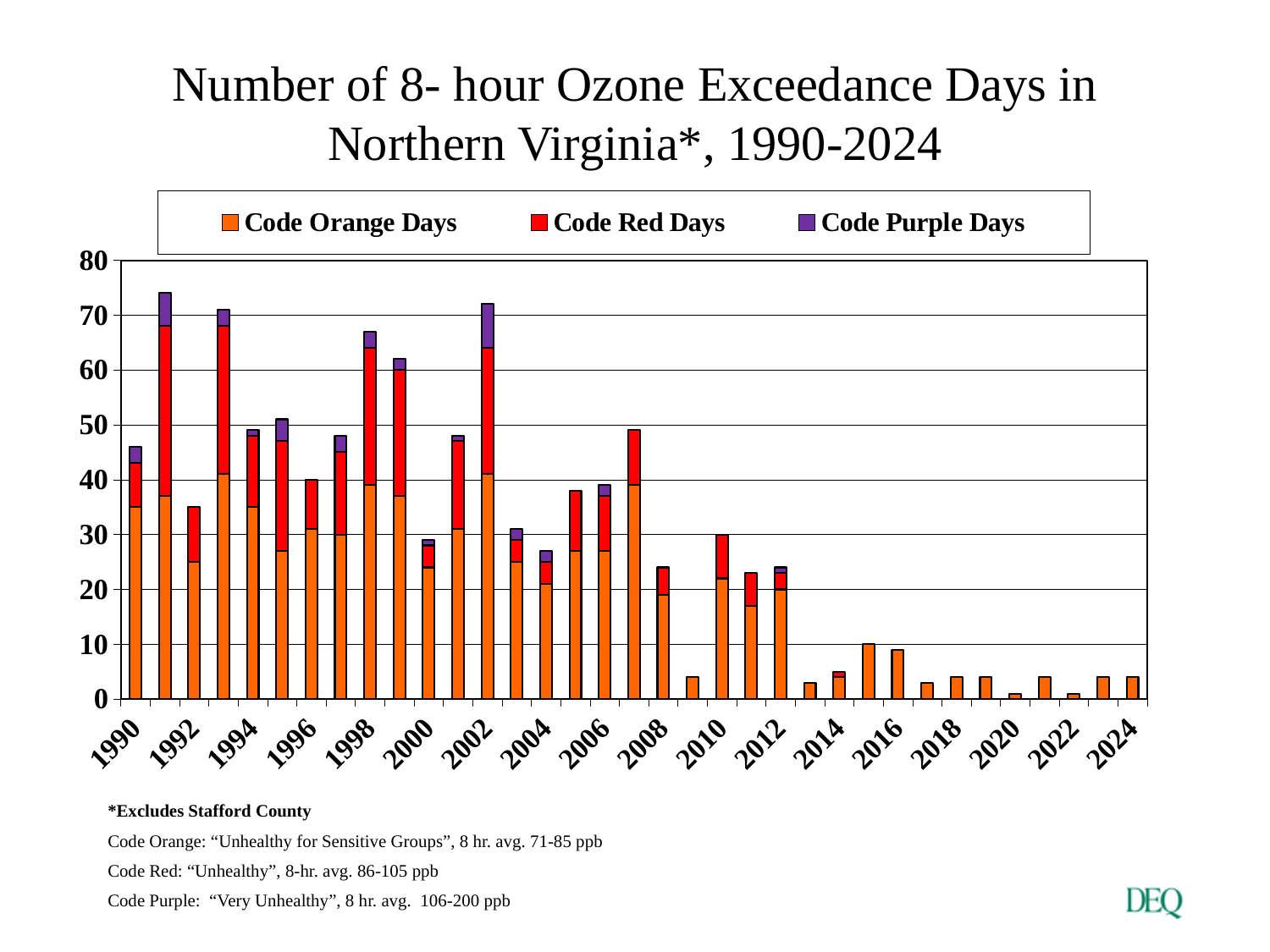
How many years are plotted on the x axis? 35 Is the total number of exceedance days in 2007 greater or less than 40? greater Which series is shown in purple in the legend? Code Purple Days What kind of chart is shown on the slide? bar chart What is the title of the chart? Number of 8- hour Ozone Exceedance Days in Northern Virginia*, 1990-2024 How many series does the legend list? 3 Is the total number of exceedance days in 2013 greater or less than 10? less Overall, do the total exceedance days rise or fall from 1990 to 2024? fall Is the total number of exceedance days in 1991 greater or less than 70? greater Which year has more total exceedance days, 2007 or 2008? 2007 Which year has more total exceedance days, 1991 or 1992? 1991